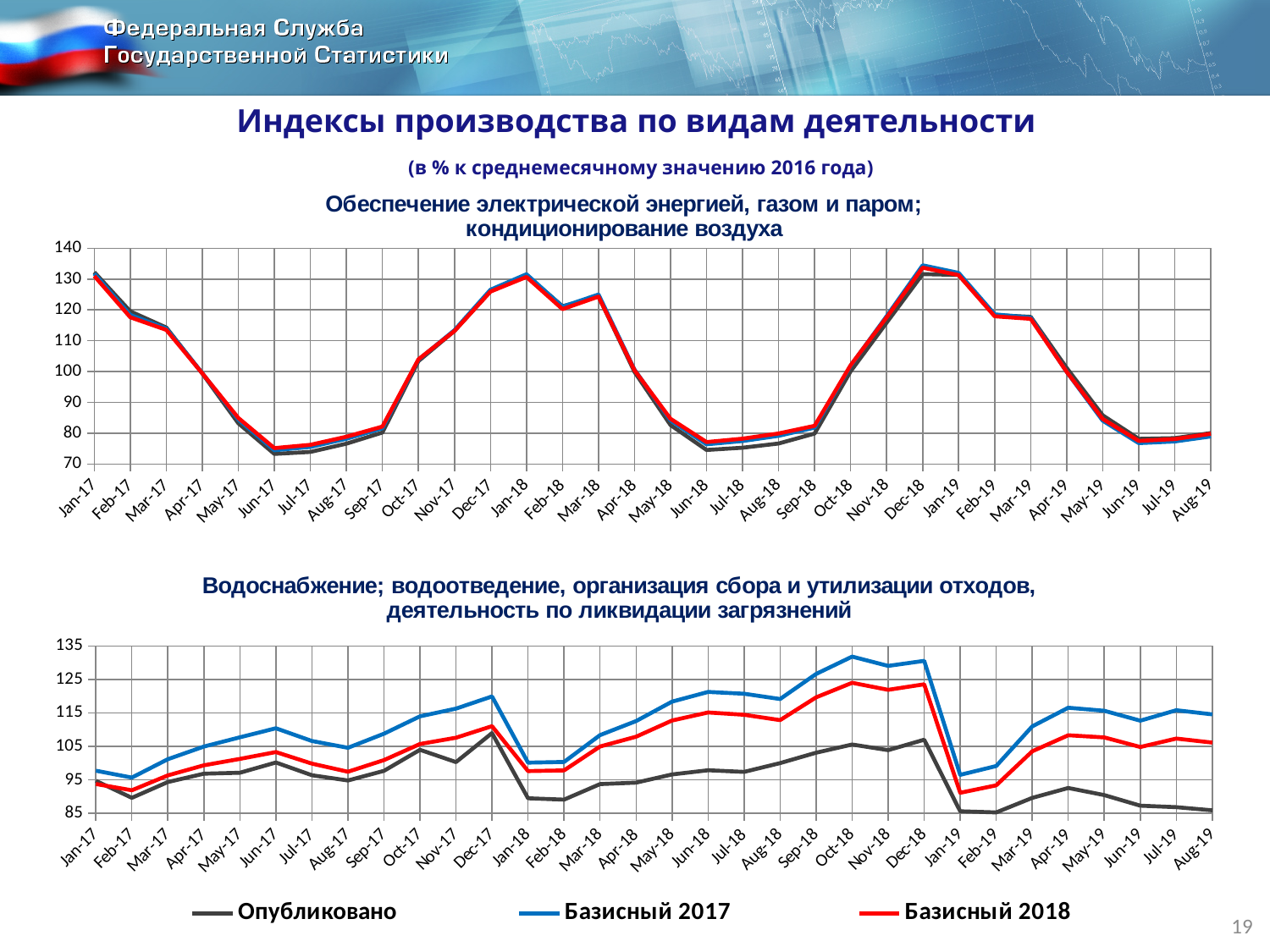
In the top chart, how many months are plotted along the x axis? 32 In the top chart, which month has the highest value? Dec-18 How many series does the legend at the bottom of the slide list? 3 In the top chart, do the values rise or fall from Jan-17 to Jun-17? fall In the bottom chart, which series is higher in Oct-18: Базисный 2017 or Опубликовано? Базисный 2017 In the bottom chart, 'Водоснабжение; водоотведение...', is the value of Базисный 2017 for Oct-18 greater or less than 125? greater In the top chart, is the value for Jan-17 greater or less than 120? greater Which series is drawn in red in the charts? Базисный 2018 What kind of chart is the top chart, 'Обеспечение электрической энергией, газом и паром; кондиционирование воздуха'? Line chart In the top chart, is the value for Jun-17 greater or less than 80? less